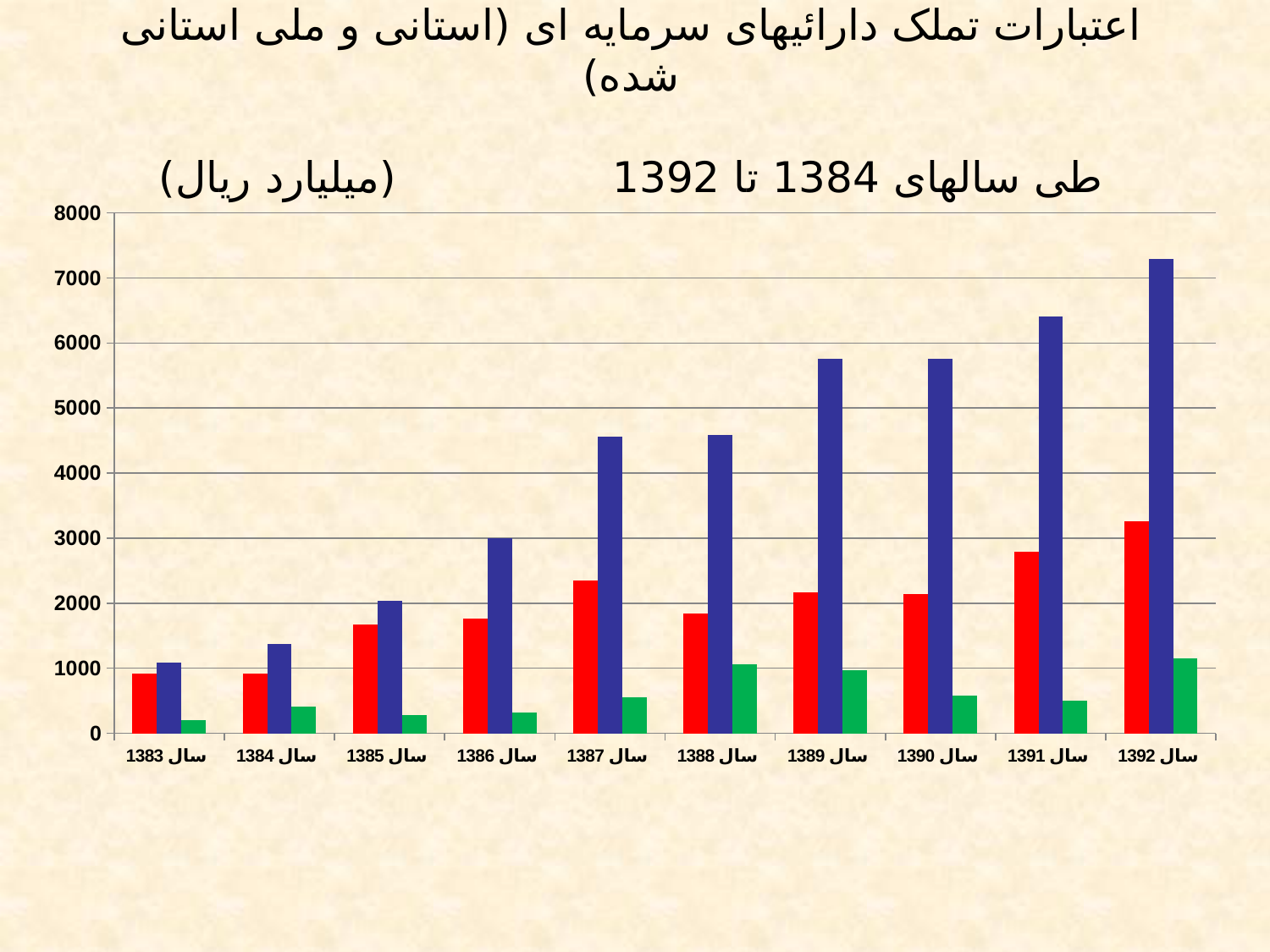
Is the value of the red bar for سال 1392 greater or less than 3000? greater Is the value of the green bar for سال 1383 greater or less than 1000? less In which year is the blue bar the highest? سال 1392 Is the value of the red bar for سال 1385 greater or less than 2000? less What is the highest value shown on the y axis? 8000 How many year categories are shown on the x axis? 10 What kind of chart is shown on the slide? bar chart In which year is the green bar the lowest? سال 1383 For سال 1392, which is larger, the blue bar or the red bar? the blue bar Do the blue bars generally rise or fall from سال 1383 to سال 1392? rise